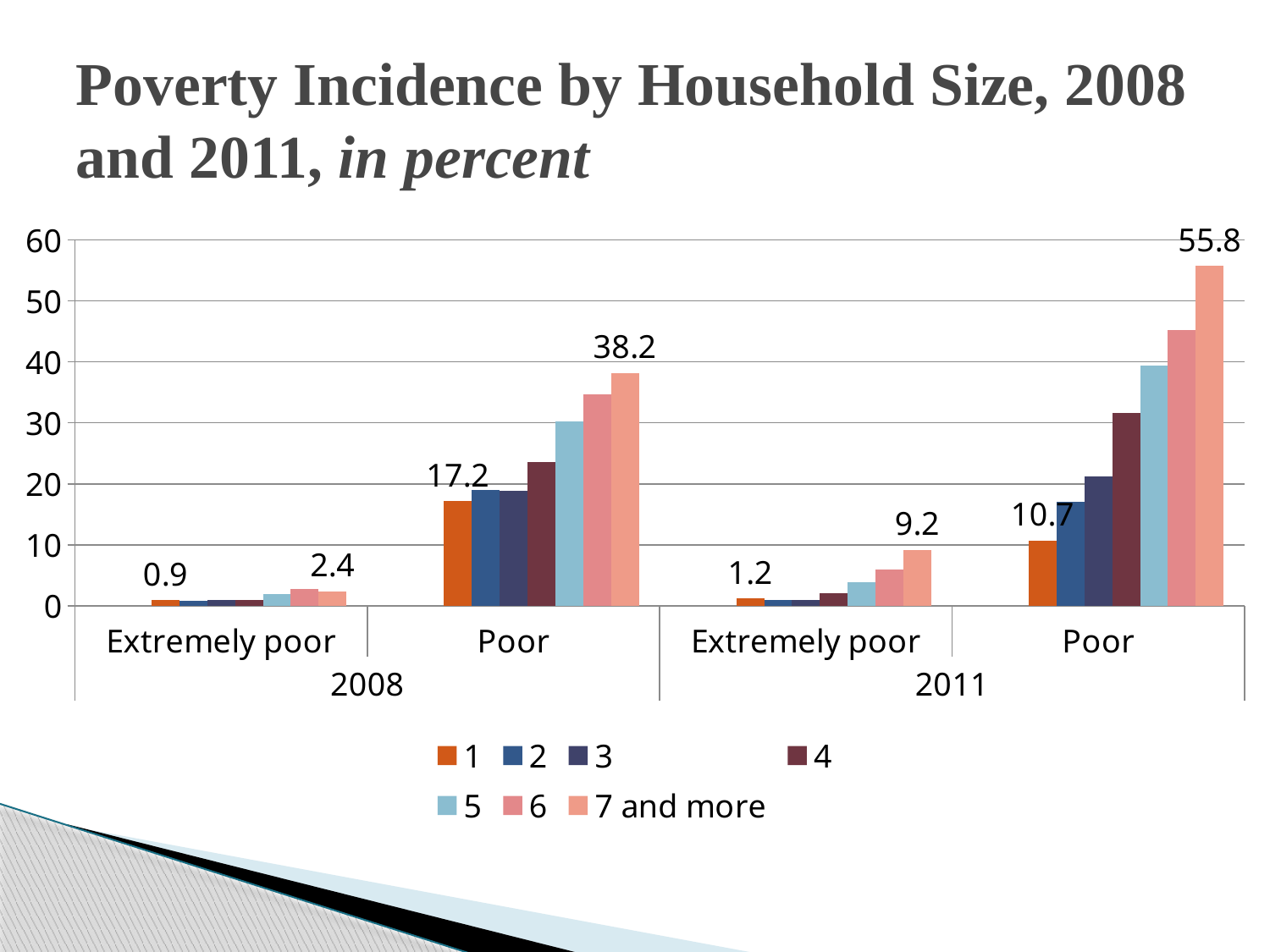
What is the value for household size 1 in the Poor category for 2008? 17.2 What is the value for household size 7 and more in the Poor category for 2011? 55.8 Which household size has the lowest value in the Poor category for 2011? 1 What kind of chart is shown on the slide? Bar chart Which household size has the highest value in the Poor category for 2011? 7 and more What is the difference between the 7 and more value for Poor in 2011 and the 7 and more value for Poor in 2008? 17.6 Is the value for household size 5 in the Poor category for 2011 greater or less than 30? greater What is the difference between the 7 and more value and the household size 1 value in the Poor category for 2011? 45.1 What is the value for household size 1 in the Extremely poor category for 2011? 1.2 What is the value for household size 7 and more in the Extremely poor category for 2008? 2.4 Is the value for household size 4 in the Poor category for 2008 greater or less than 30? less How many series does the legend list? 7